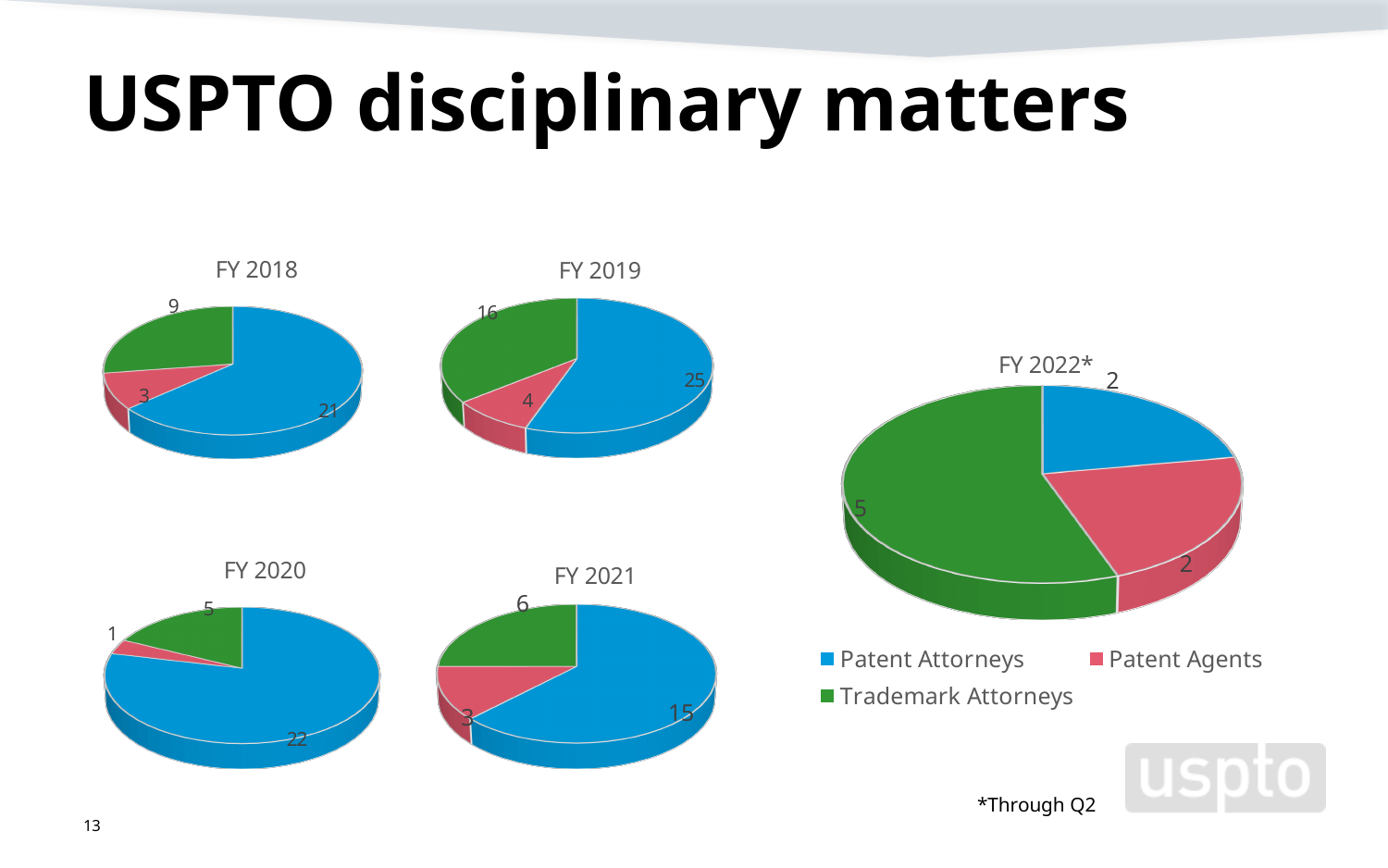
How many series does the legend list? 3 In the FY 2018 chart, which category has the lowest value? Patent Agents What is the total of all slices in the FY 2020 chart? 28 In the FY 2018 chart, what is the value for Patent Attorneys? 21 In the FY 2019 chart, what is the difference between Patent Attorneys and Trademark Attorneys? 9 In the FY 2019 chart, what is the value for Trademark Attorneys? 16 What kind of chart is used for FY 2019? Pie chart In the FY 2021 chart, which category has the highest value? Patent Attorneys In the FY 2020 chart, what is the value for Patent Agents? 1 In the FY 2021 chart, which is larger, Trademark Attorneys or Patent Agents? Trademark Attorneys In the FY 2022* chart, which category has the highest value? Trademark Attorneys How many pie charts are shown on the slide? 5